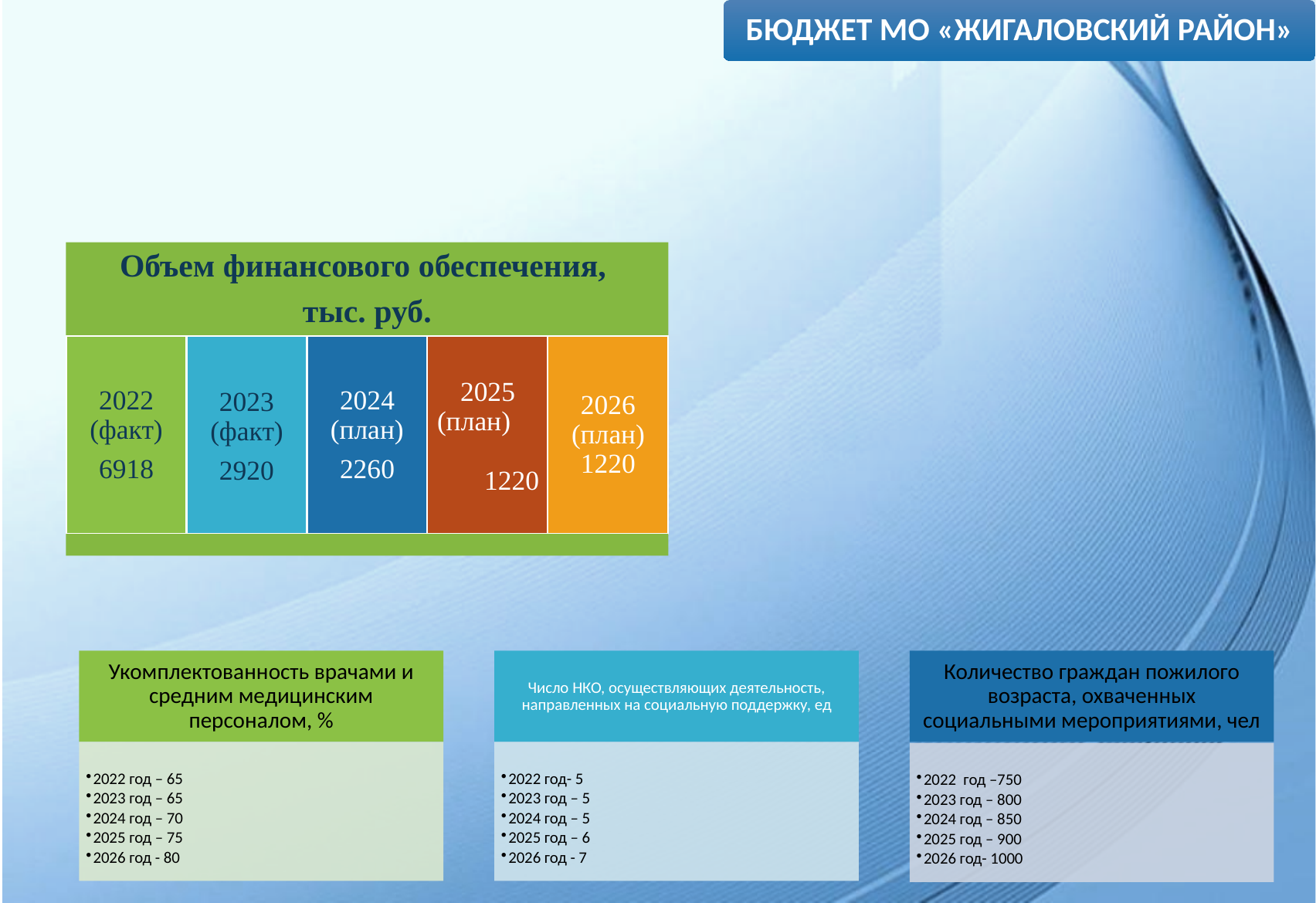
In the 'Объем финансового обеспечения, тыс. руб.' graphic, which year has the highest value? 2022 (факт) How many year categories are shown in the 'Объем финансового обеспечения, тыс. руб.' graphic? 5 In the 'Объем финансового обеспечения, тыс. руб.' graphic, what is the value for 2026 (план)? 1220 In the 'Объем финансового обеспечения, тыс. руб.' graphic, what is the value for 2025 (план)? 1220 In the 'Объем финансового обеспечения, тыс. руб.' graphic, what is the difference between the 2024 (план) and 2025 (план) values? 1040 In the 'Объем финансового обеспечения, тыс. руб.' graphic, what is the value for 2024 (план)? 2260 In the 'Объем финансового обеспечения, тыс. руб.' graphic, what is the value for 2022 (факт)? 6918 In the 'Объем финансового обеспечения, тыс. руб.' graphic, what is the difference between the 2022 (факт) and 2023 (факт) values? 3998 What unit is stated in the title of the 'Объем финансового обеспечения' graphic? тыс. руб. In the 'Объем финансового обеспечения, тыс. руб.' graphic, which is larger: the value for 2023 (факт) or 2024 (план)? 2023 (факт) In the 'Объем финансового обеспечения, тыс. руб.' graphic, do the values rise or fall from 2022 to 2026? fall In the 'Объем финансового обеспечения, тыс. руб.' graphic, what is the value for 2023 (факт)? 2920